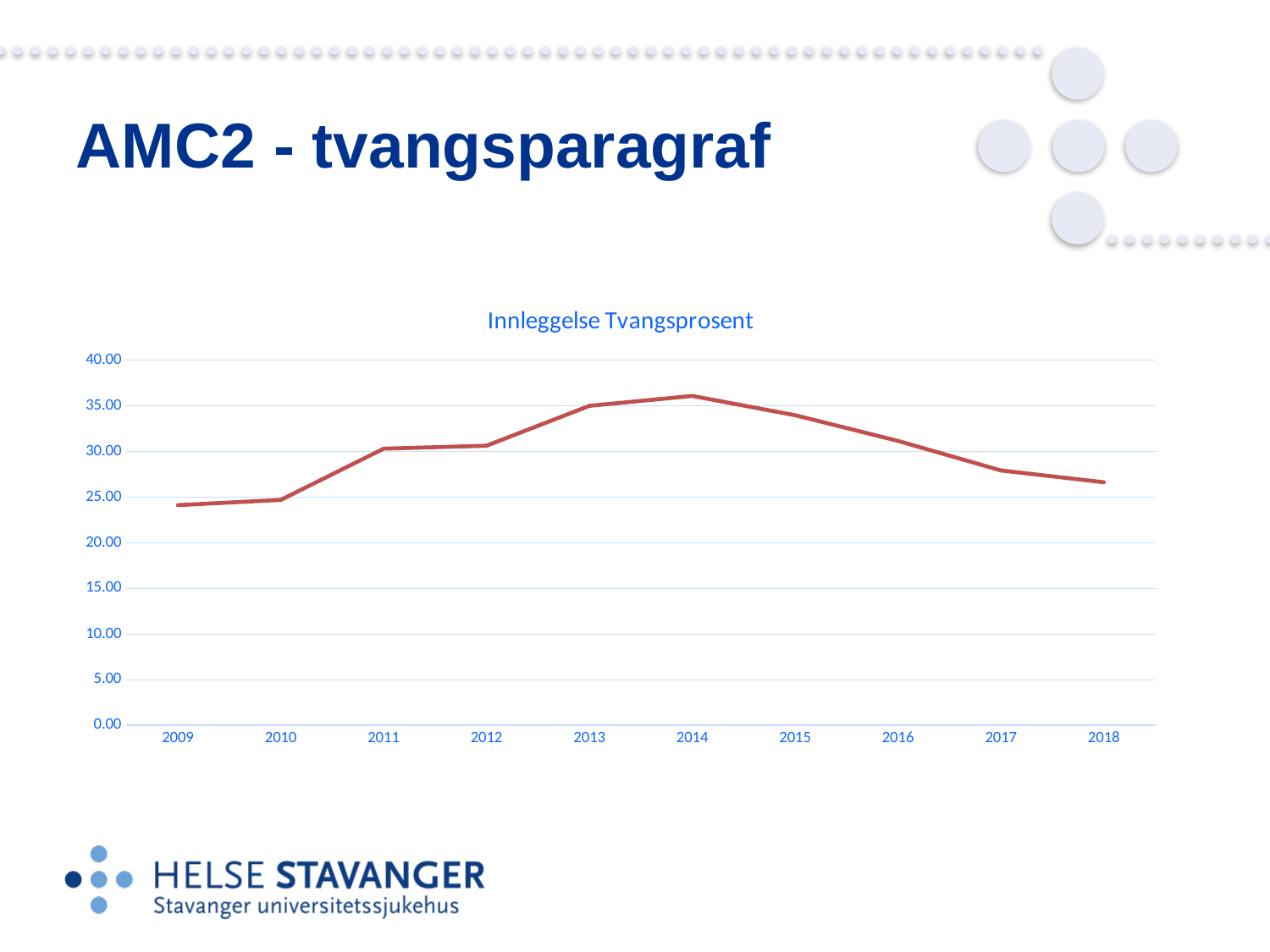
How many years are plotted on the x axis of the chart? 10 Is the value for 2017 greater or less than 30.00? less Do the values rise or fall from 2009 to 2014? rise Do the values rise or fall from 2014 to 2018? fall Which year has the larger value, 2013 or 2017? 2013 Which year has the highest value in the chart? 2014 What kind of chart is shown on the slide? line chart Which year has the larger value, 2009 or 2011? 2011 Is the value for 2013 greater or less than 30.00? greater Is the value for 2014 greater or less than 30.00? greater What is the title of the chart? Innleggelse Tvangsprosent